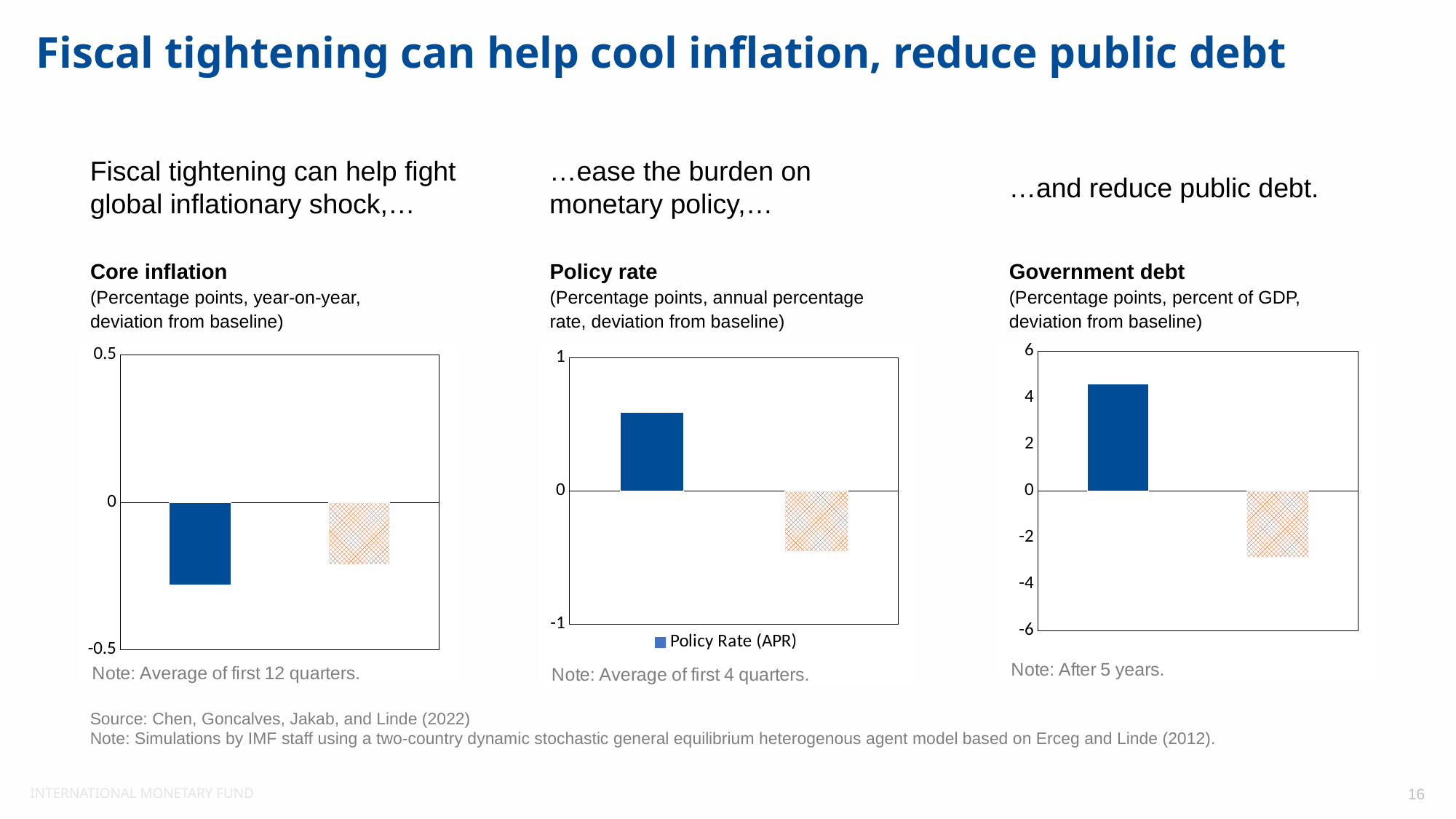
In the Core inflation chart, which bar has the lower value, the solid blue bar or the hatched bar? the solid blue bar In the Policy rate chart, is the value of the hatched bar greater or less than 0? less In the Core inflation chart, is the value of the solid blue bar greater or less than 0? less How many bars are plotted in the Government debt chart? 2 In the Government debt chart, is the value of the solid blue bar greater or less than 4? greater In the Policy rate chart, what is the legend entry? Policy Rate (APR) What is the maximum value shown on the vertical axis of the Government debt chart? 6 In the Government debt chart, which bar has the higher value, the solid blue bar or the hatched bar? the solid blue bar How many series does the legend of the Policy rate chart list? 1 What kind of chart is the Core inflation chart? bar chart